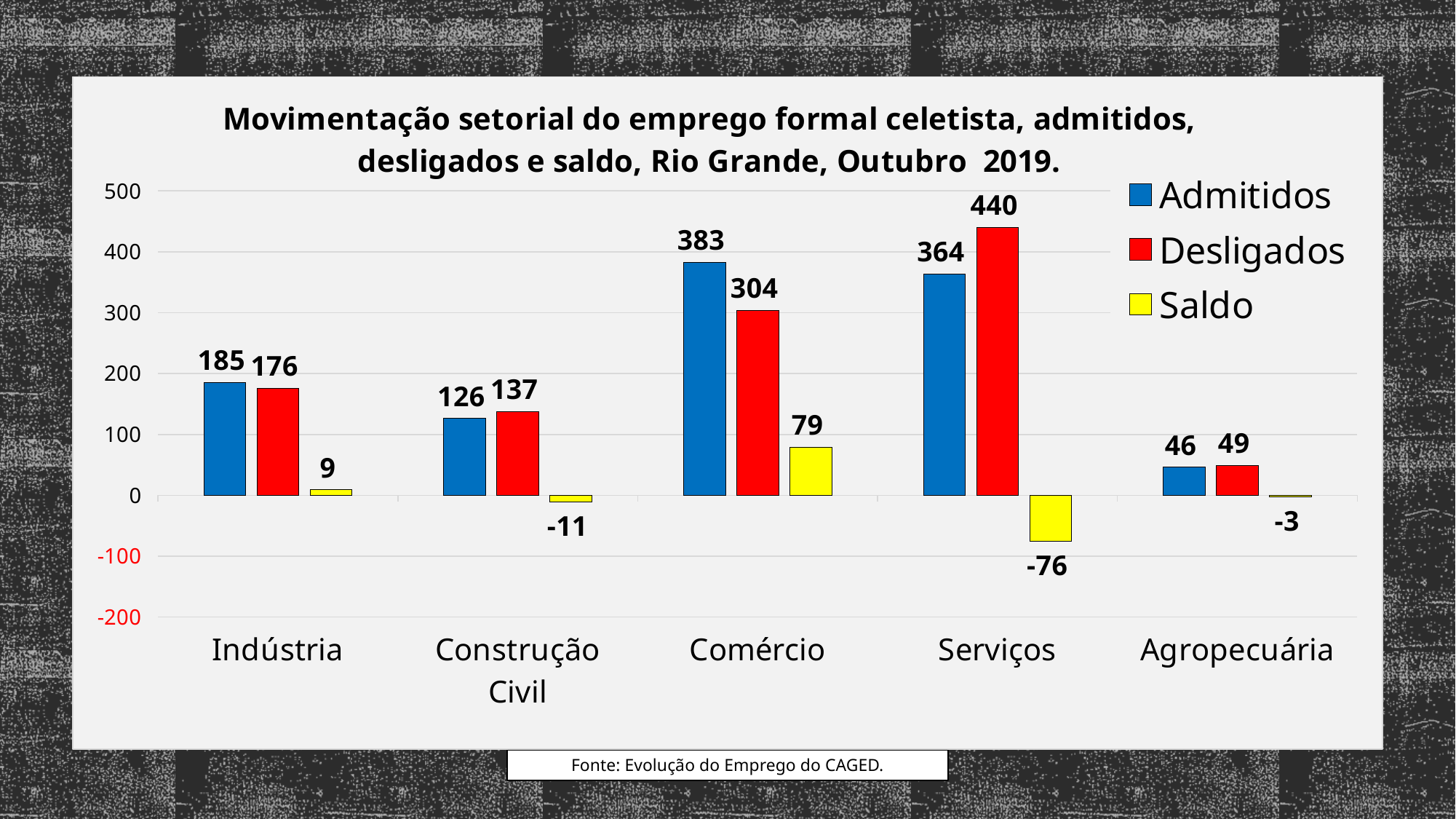
What is the Admitidos value for Comércio? 383 What is the Desligados value for Serviços? 440 Is the Admitidos value for Serviços greater or less than 300? greater What is the difference between Admitidos and Desligados for Indústria? 9 What colour represents the Saldo series? yellow Which sector has the lowest Admitidos value? Agropecuária How many sectors are shown on the x axis? 5 What is the Saldo value for Construção Civil? -11 How many series does the legend list? 3 Which sector has the highest Desligados value? Serviços Which is larger for Agropecuária, Admitidos or Desligados? Desligados What kind of chart is shown? bar chart